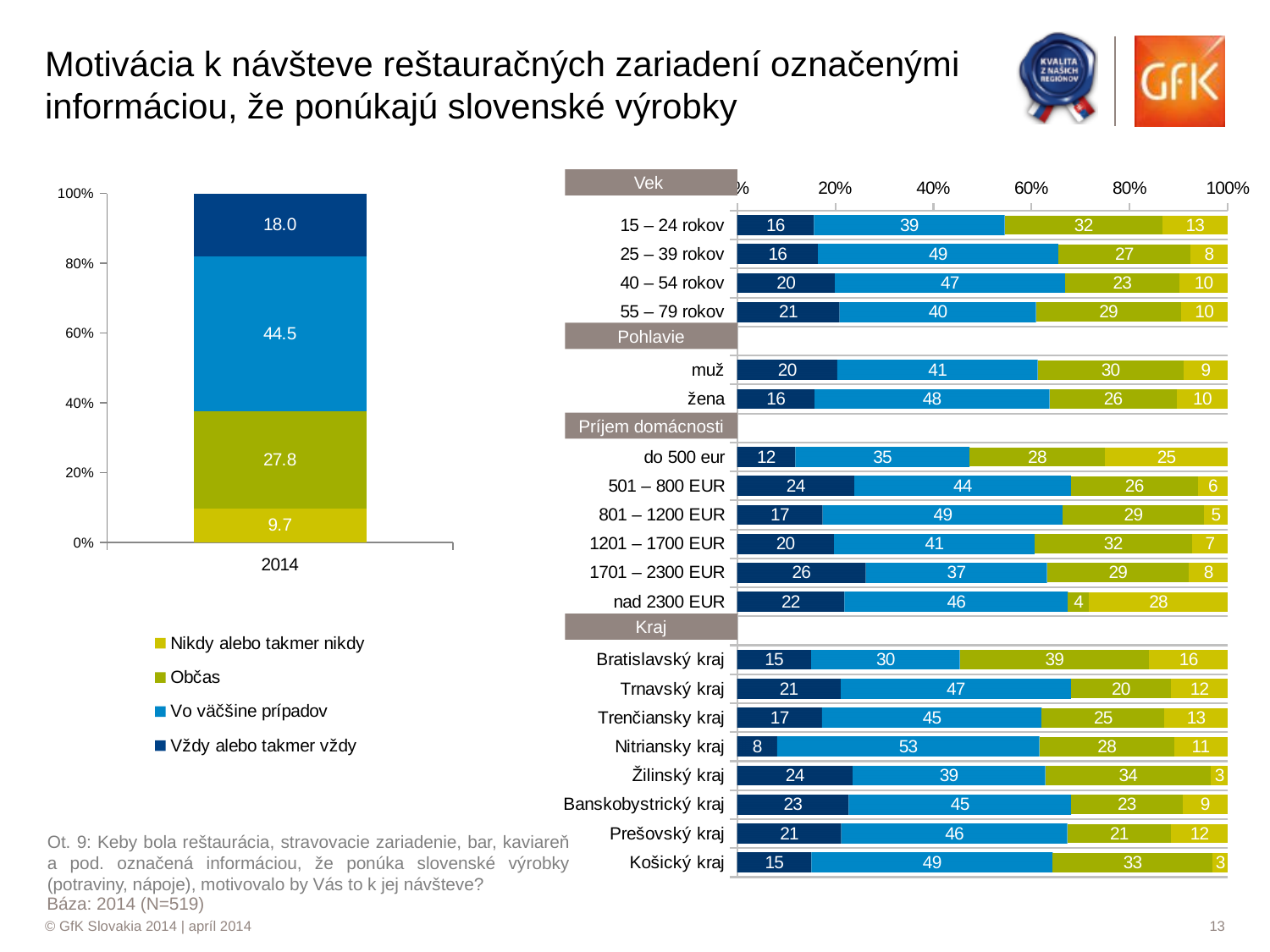
On the right chart, what is the value of the first (dark blue) segment for 'Nitriansky kraj'? 8 On the left chart, what is the value of the 'Nikdy alebo takmer nikdy' segment for 2014? 9.7 On the left chart, which segment of the 2014 bar is the smallest? Nikdy alebo takmer nikdy How many series does the legend of the left chart list? 4 On the right chart, what is the value of the second (light blue) segment for '25 – 39 rokov'? 49 On the right chart, what is the value of the last (yellow) segment for 'do 500 eur'? 25 On the right chart, which row has the highest value in the first (dark blue) segment? 1701 – 2300 EUR On the left chart, what is the difference between the 'Občas' and 'Vždy alebo takmer vždy' values for 2014? 9.8 On the left chart, what is the value of the 'Vo väčšine prípadov' segment for 2014? 44.5 What type of chart is the chart on the right side of the slide? Stacked bar chart On the right chart, is the light blue segment larger for 'Nitriansky kraj' or for 'Bratislavský kraj'? Nitriansky kraj On the left chart, which segment of the 2014 bar is the largest? Vo väčšine prípadov